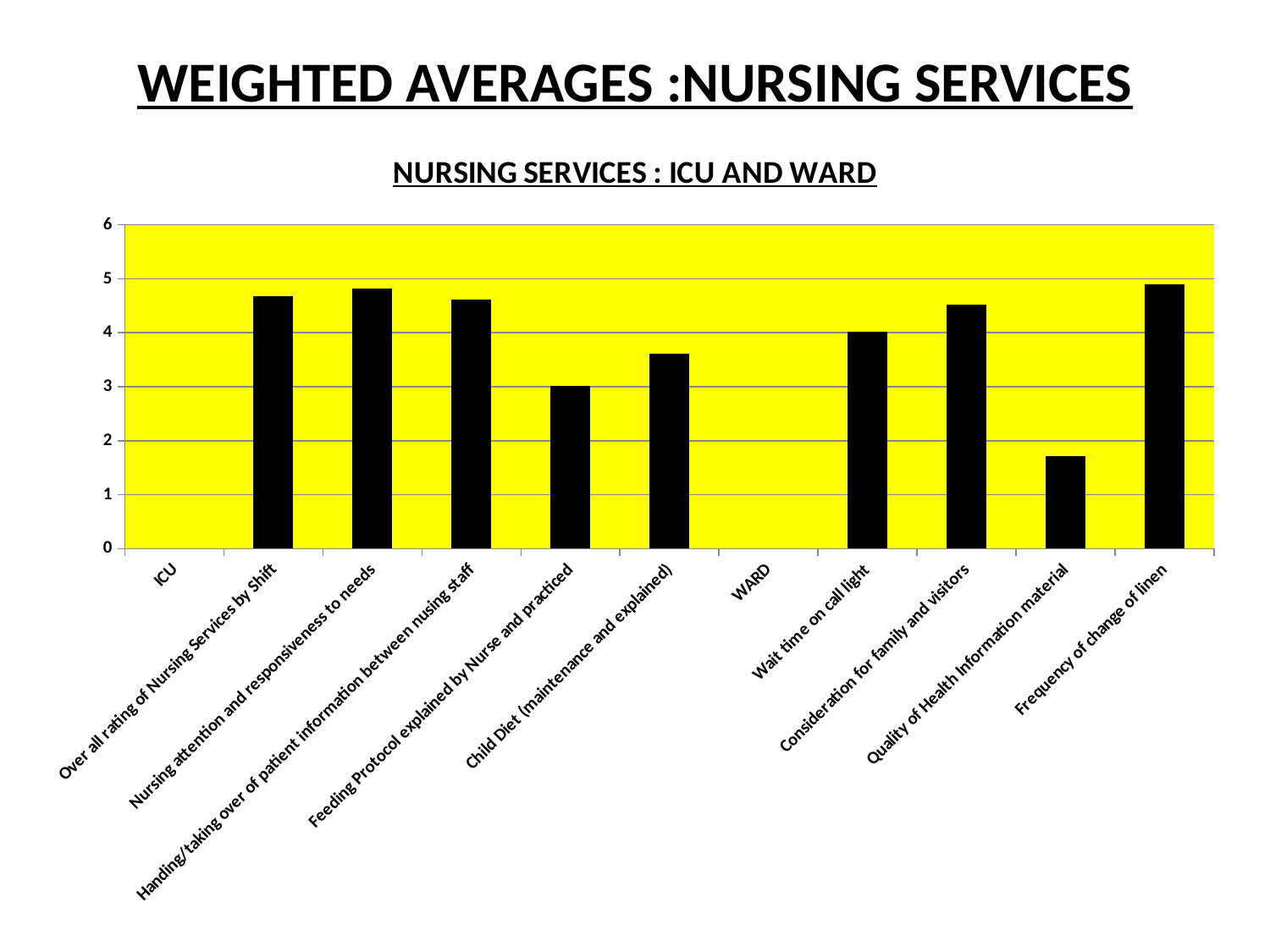
Is the value for Quality of Health Information material greater or less than 2? less Which is larger: the value for Child Diet (maintenance and explained) or the value for Feeding Protocol explained by Nurse and practiced? Child Diet (maintenance and explained) How many bars are plotted in the chart? 10 What type of chart is shown on the slide? bar chart Is the value for Consideration for family and visitors greater or less than 4? greater Is the value for Child Diet (maintenance and explained) greater or less than 3? greater Which is larger: the value for Consideration for family and visitors or the value for Wait time on call light? Consideration for family and visitors Which category has the lowest value? Quality of Health Information material What is the title of the chart? NURSING SERVICES : ICU AND WARD